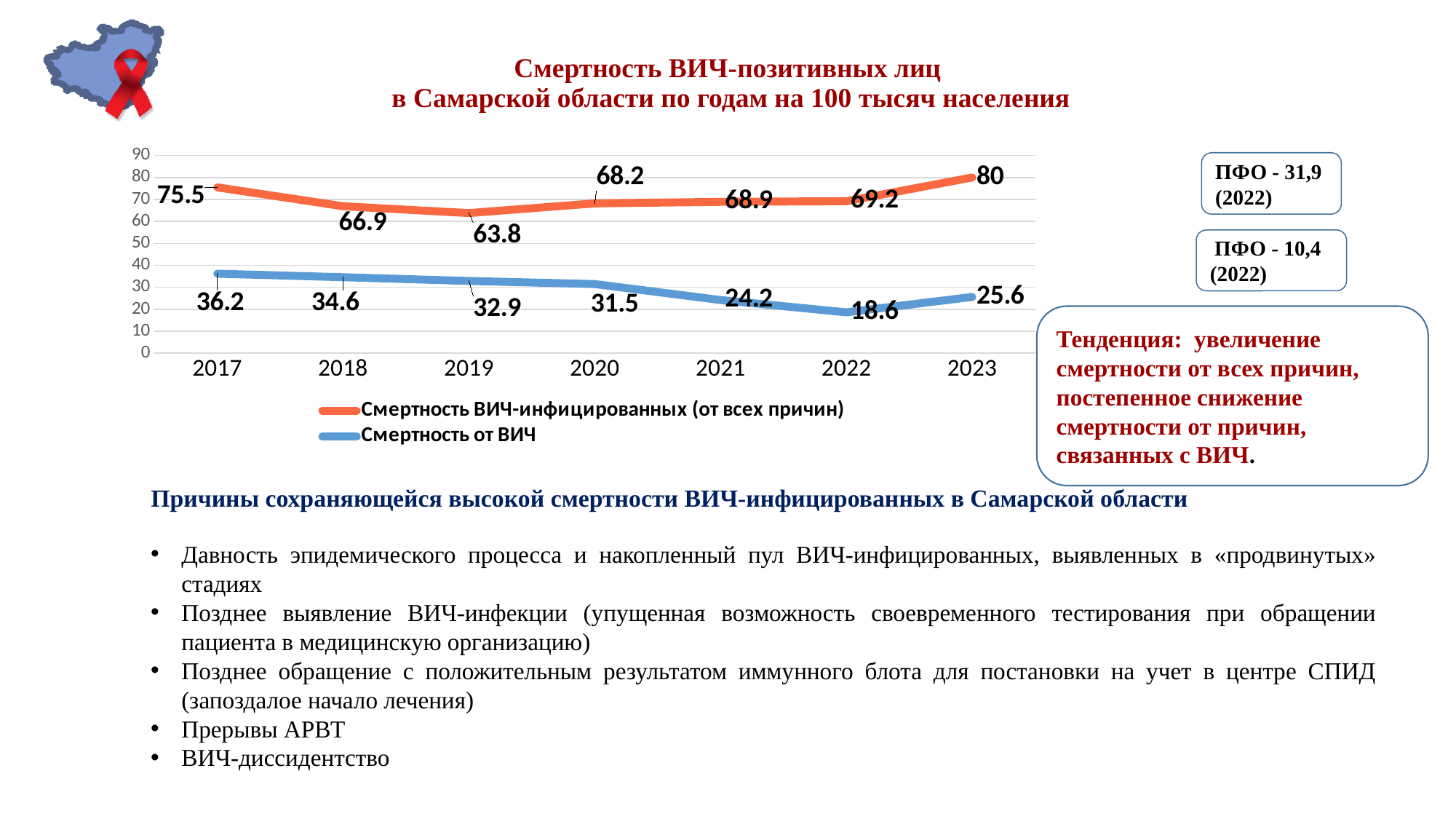
What is the difference between 'Смертность ВИЧ-инфицированных (от всех причин)' in 2023 and in 2022? 10.8 In which year was 'Смертность от ВИЧ' lowest? 2022 What was the value of 'Смертность от ВИЧ' in 2022? 18.6 How many series does the chart legend list? 2 What is the difference between 'Смертность от ВИЧ' in 2017 and in 2023? 10.6 What was the value of 'Смертность ВИЧ-инфицированных (от всех причин)' in 2017? 75.5 What was the value of 'Смертность от ВИЧ' in 2020? 31.5 In which year was 'Смертность ВИЧ-инфицированных (от всех причин)' highest? 2023 Which is larger: 'Смертность от ВИЧ' in 2021 or in 2023? 2023 How many years are shown on the x axis of the chart? 7 What kind of chart is shown on the slide? Line chart In which year was 'Смертность ВИЧ-инфицированных (от всех причин)' lowest? 2019